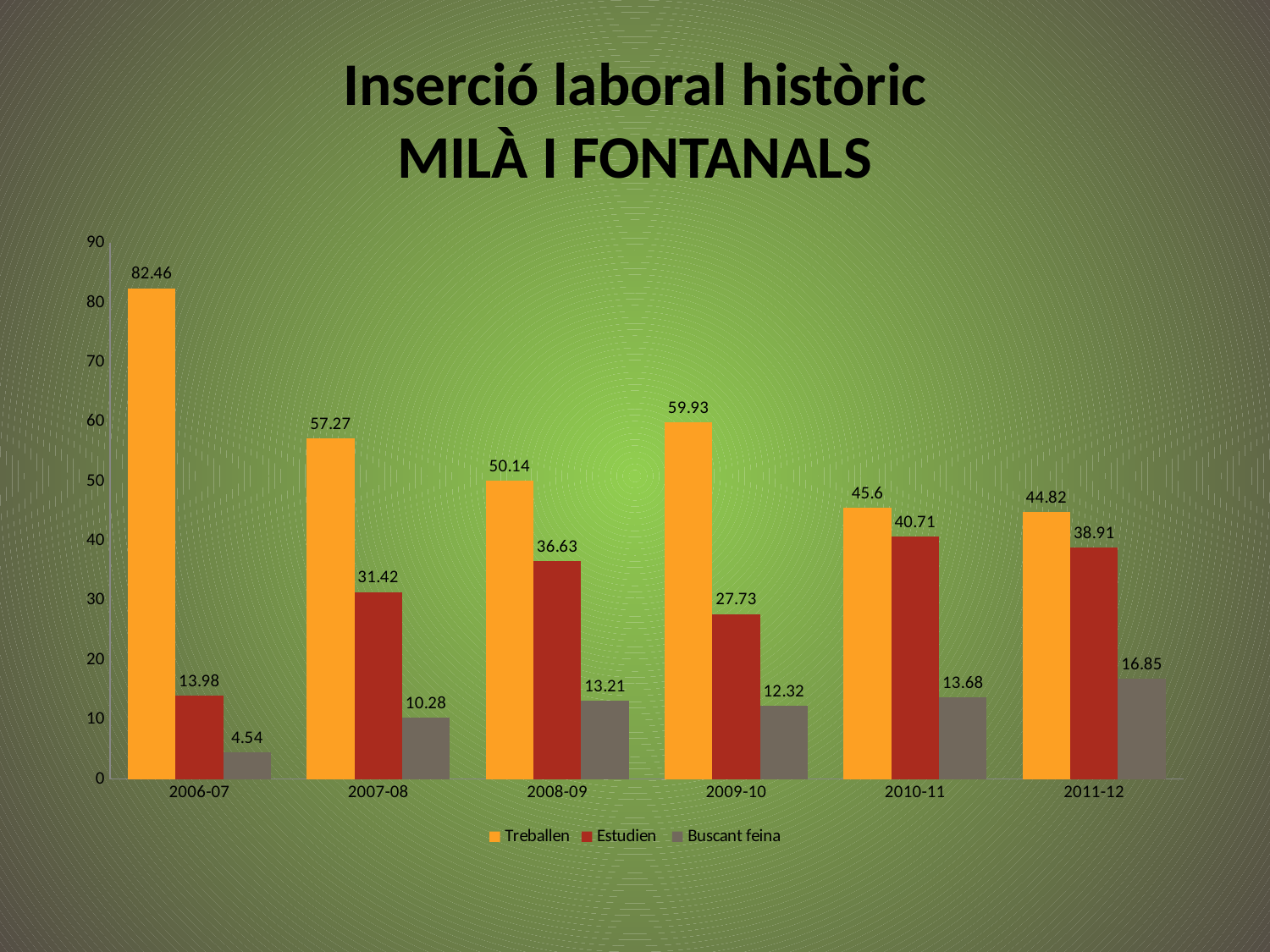
What is the value for Estudien in 2010-11? 40.71 How many years are shown on the x axis? 6 Is the value for Estudien in 2008-09 greater or less than 30? greater Which series is shown in orange in the legend? Treballen What is the difference between the Treballen and Estudien values in 2011-12? 5.91 How many series does the legend list? 3 Which year has the lowest value for Buscant feina? 2006-07 What kind of chart is shown on the slide? Bar chart What is the value for Buscant feina in 2011-12? 16.85 What is the value for Treballen in 2006-07? 82.46 Which is larger in 2009-10, Treballen or Estudien? Treballen Which year has the highest value for Treballen? 2006-07